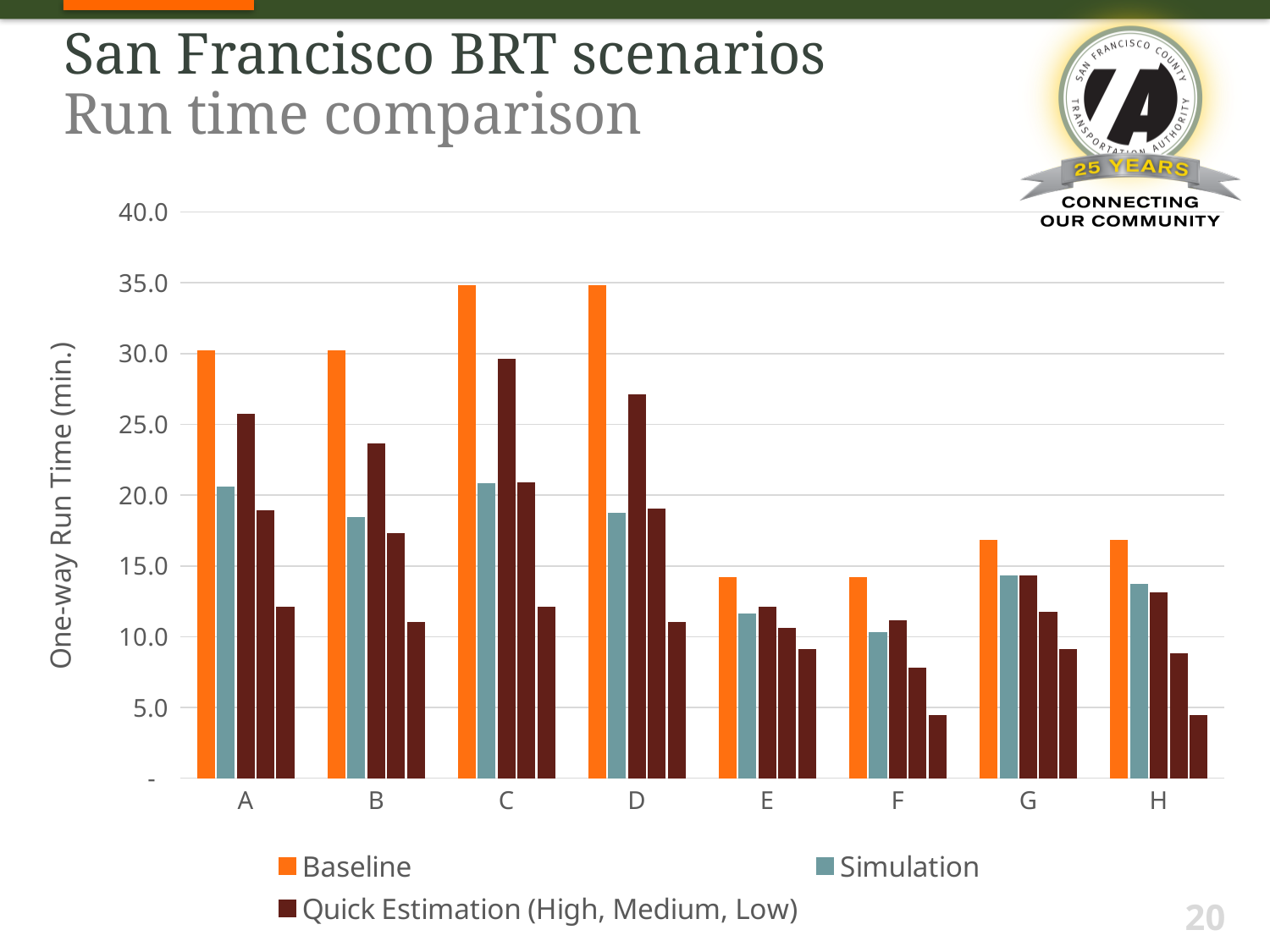
Is the Simulation value for scenario B greater or less than 20? less What kind of chart is shown on the slide? bar chart Is the Baseline value for scenario C greater or less than 30? greater What is the label of the vertical axis? One-way Run Time (min.) Is the Simulation value for scenario H greater or less than 15? less For scenario A, which is larger, the Baseline value or the Simulation value? Baseline How many series does the legend list? 3 Which is larger, the Baseline value for scenario C or the Baseline value for scenario E? scenario C How many scenario categories are shown on the x axis? 8 Which series is shown in orange in the legend? Baseline